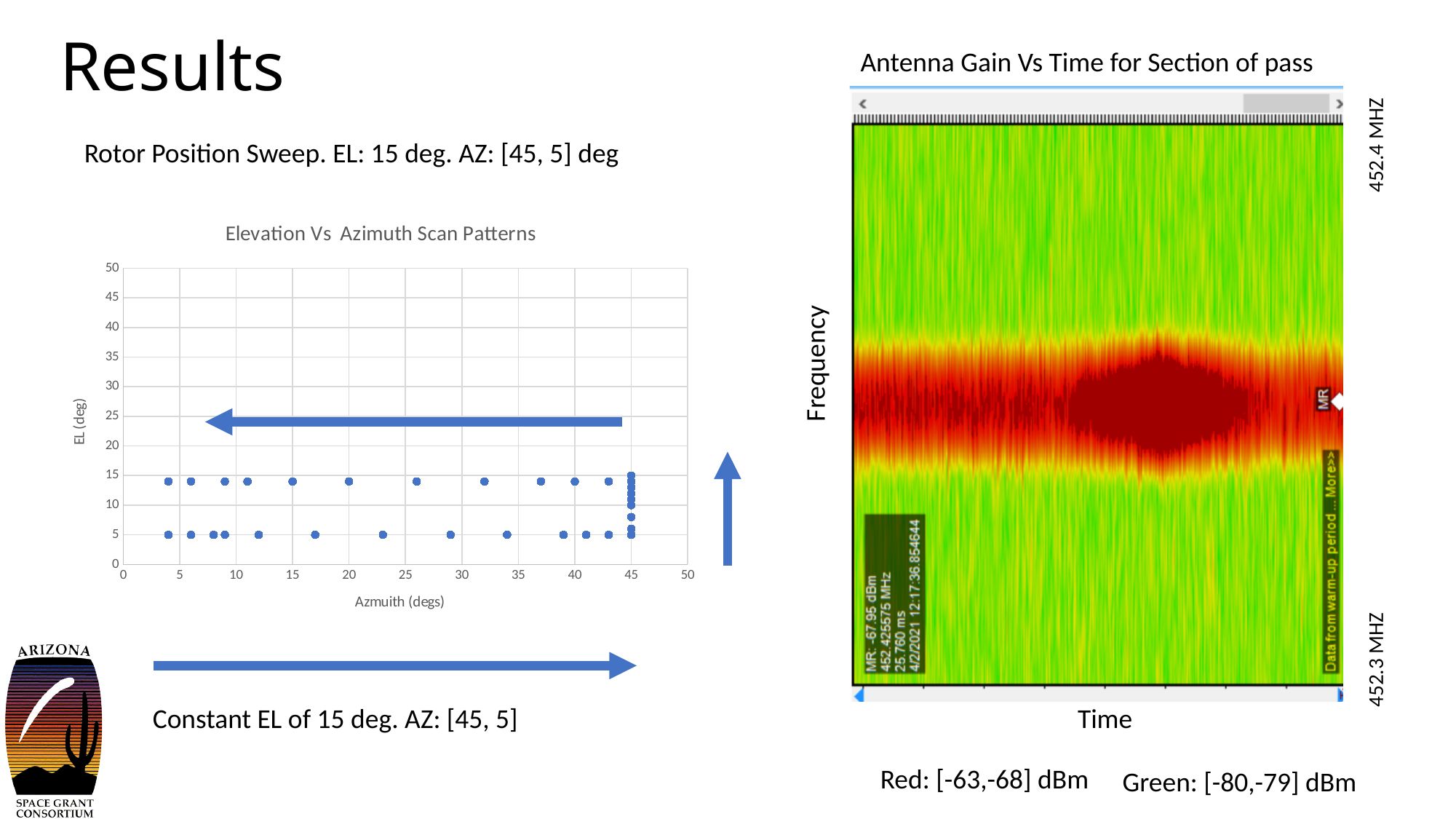
What kind of chart is the 'Elevation Vs Azimuth Scan Patterns' chart? scatter chart In the 'Elevation Vs Azimuth Scan Patterns' chart, what is the label of the x axis? Azmuith (degs) In the 'Elevation Vs Azimuth Scan Patterns' chart, what is the highest value shown on the Azmuith (degs) axis? 50 What is the title of the chart on the left side of the slide? Elevation Vs Azimuth Scan Patterns In the 'Elevation Vs Azimuth Scan Patterns' chart, are the points in the upper row at a higher or lower EL value than the points in the lower row? higher In the 'Elevation Vs Azimuth Scan Patterns' chart, is the EL value of the lower row of points greater or less than 10? less In the 'Elevation Vs Azimuth Scan Patterns' chart, is the EL value of the lower row of points greater or less than 25? less In the 'Elevation Vs Azimuth Scan Patterns' chart, at which azimuth value is the vertical cluster of points located? 45 In the 'Elevation Vs Azimuth Scan Patterns' chart, what is the highest value shown on the EL (deg) axis? 50 In the 'Elevation Vs Azimuth Scan Patterns' chart, is the EL value of the upper row of points greater or less than 20? less